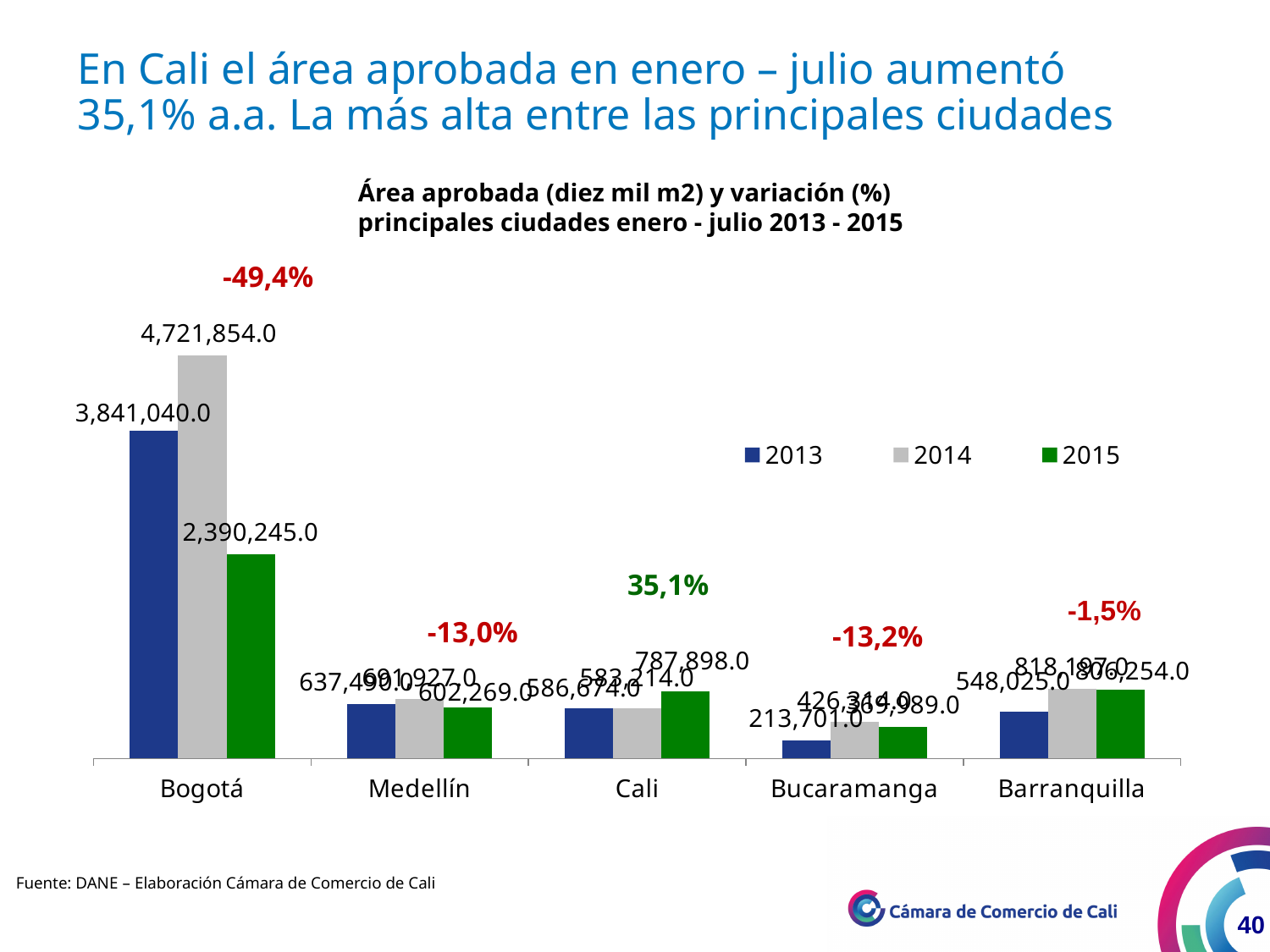
How many cities are shown on the x axis? 5 What percentage variation is shown above the Cali bars? 35,1% How many series does the legend list? 3 For Bogotá, which year has the larger value, 2014 or 2015? 2014 What is the difference between the 2014 and 2013 values for Bogotá? 880,814.0 Which city has the highest value in 2014? Bogotá Which city has the lowest value in 2013? Bucaramanga What is the value for Bucaramanga in 2013? 213,701.0 What is the value for Cali in 2015? 787,898.0 What is the value for Bogotá in 2015? 2,390,245.0 What is the value for Bogotá in 2014? 4,721,854.0 What percentage variation is shown above the Bogotá bars? -49,4%